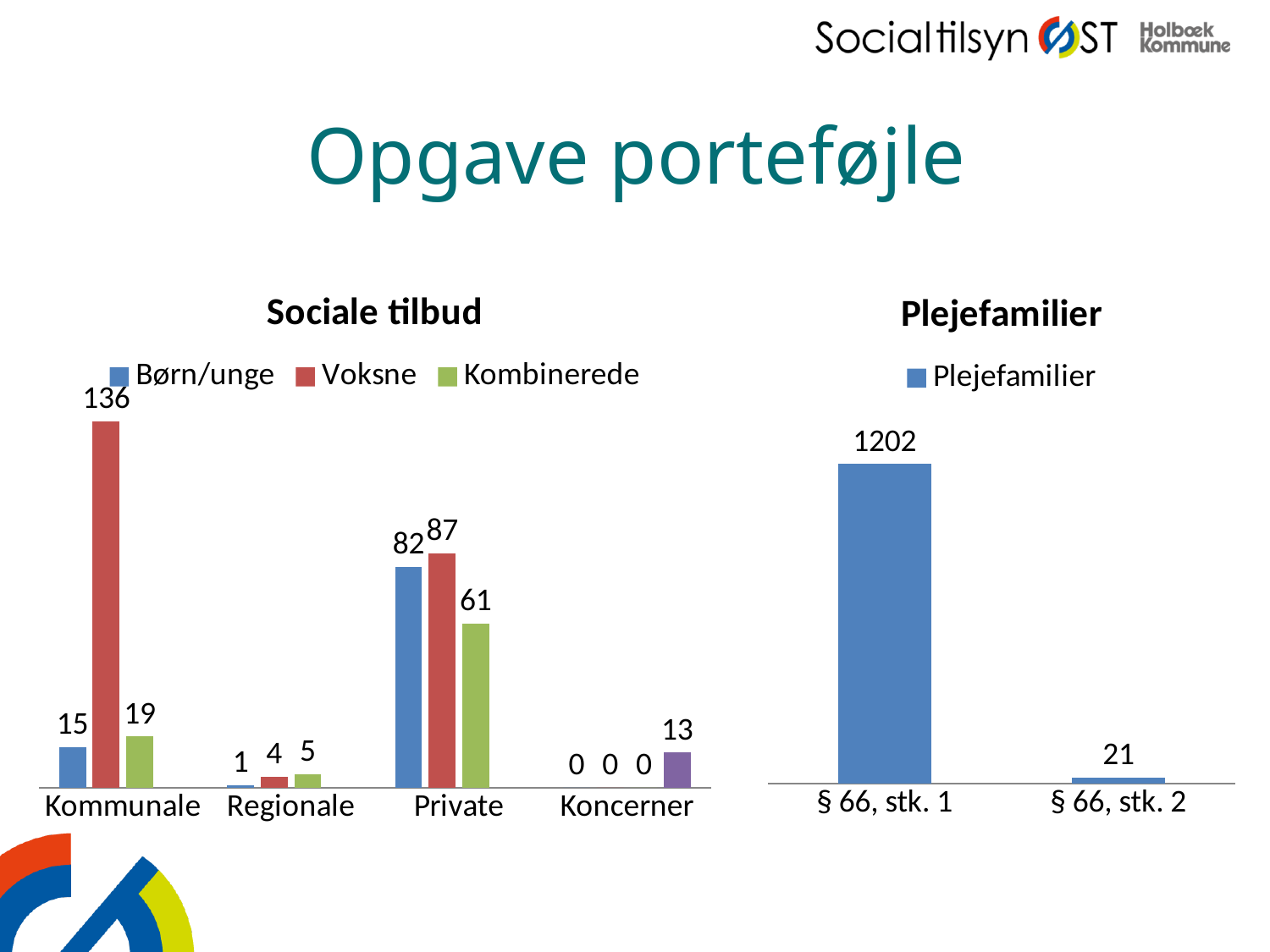
In the 'Sociale tilbud' chart, what is the value for Kombinerede in the Private category? 61 In the 'Sociale tilbud' chart, what is the difference between the Voksne and Børn/unge values in the Private category? 5 How many categories are shown on the x axis of the 'Sociale tilbud' chart? 4 How many series does the legend of the 'Sociale tilbud' chart list? 3 What is the title of the chart on the left side of the slide? Sociale tilbud In the 'Sociale tilbud' chart, what is the value for Voksne in the Kommunale category? 136 In the 'Plejefamilier' chart, what is the value for § 66, stk. 1? 1202 In the 'Sociale tilbud' chart, which is larger: Børn/unge for Kommunale or Børn/unge for Private? Private In the 'Plejefamilier' chart, what is the difference between § 66, stk. 1 and § 66, stk. 2? 1181 What type of chart is the 'Plejefamilier' chart? Bar chart In the 'Sociale tilbud' chart, which category has the highest Voksne value? Kommunale In the 'Sociale tilbud' chart, what is the value for Børn/unge in the Regionale category? 1